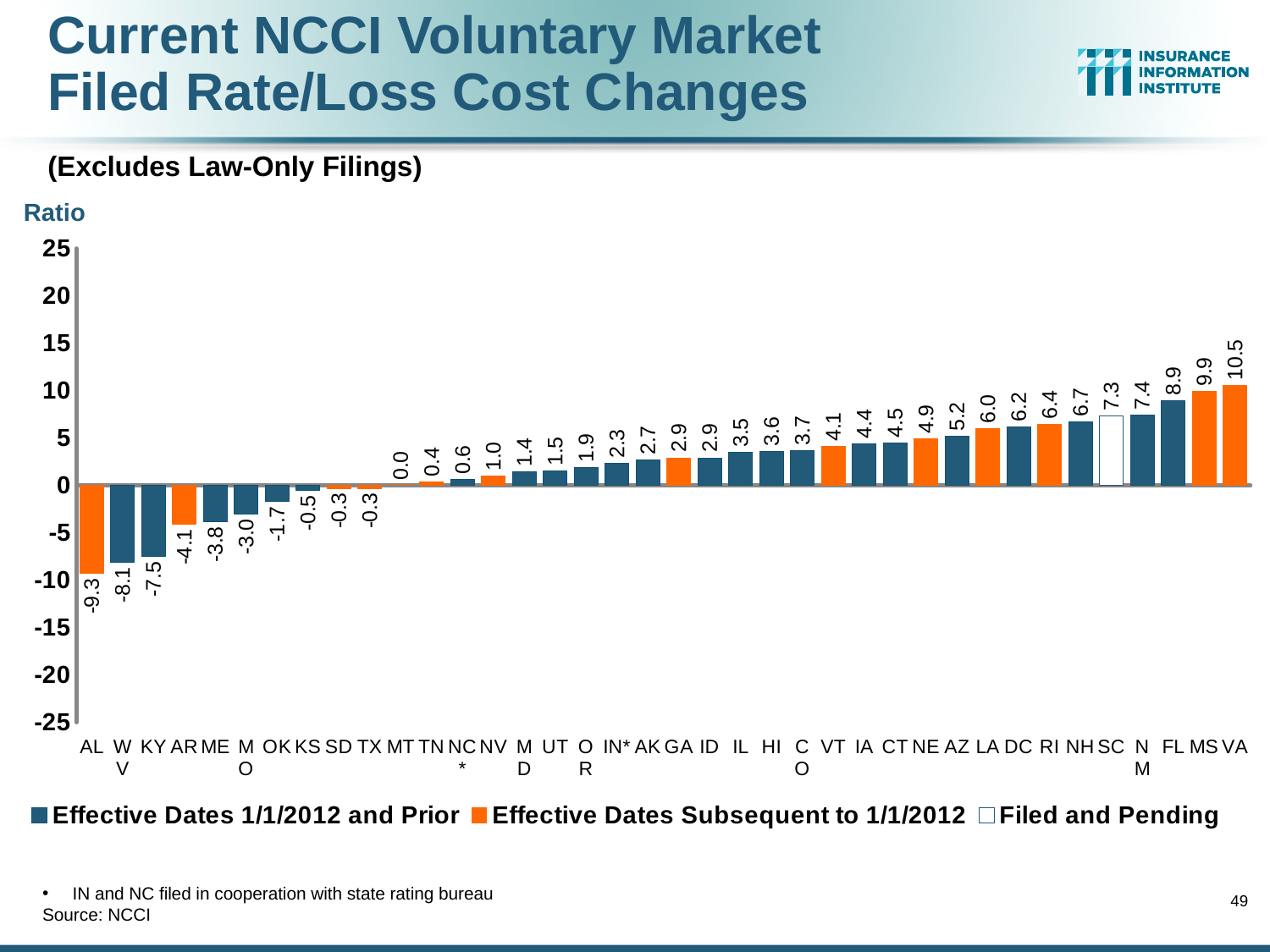
What is the value for VA? 10.5 Which state has the lowest value? AL How many states are shown on the x axis? 38 Which has a larger value, FL or MS? MS What is the value for MT? 0.0 Which state has the highest value? VA What is the difference between the values for VA and AL? 19.8 What is the value for AL? -9.3 Is the value for VA greater or less than 10? greater What kind of chart is this? bar chart Which state's bar belongs to the 'Filed and Pending' series? SC How many series does the legend list? 3